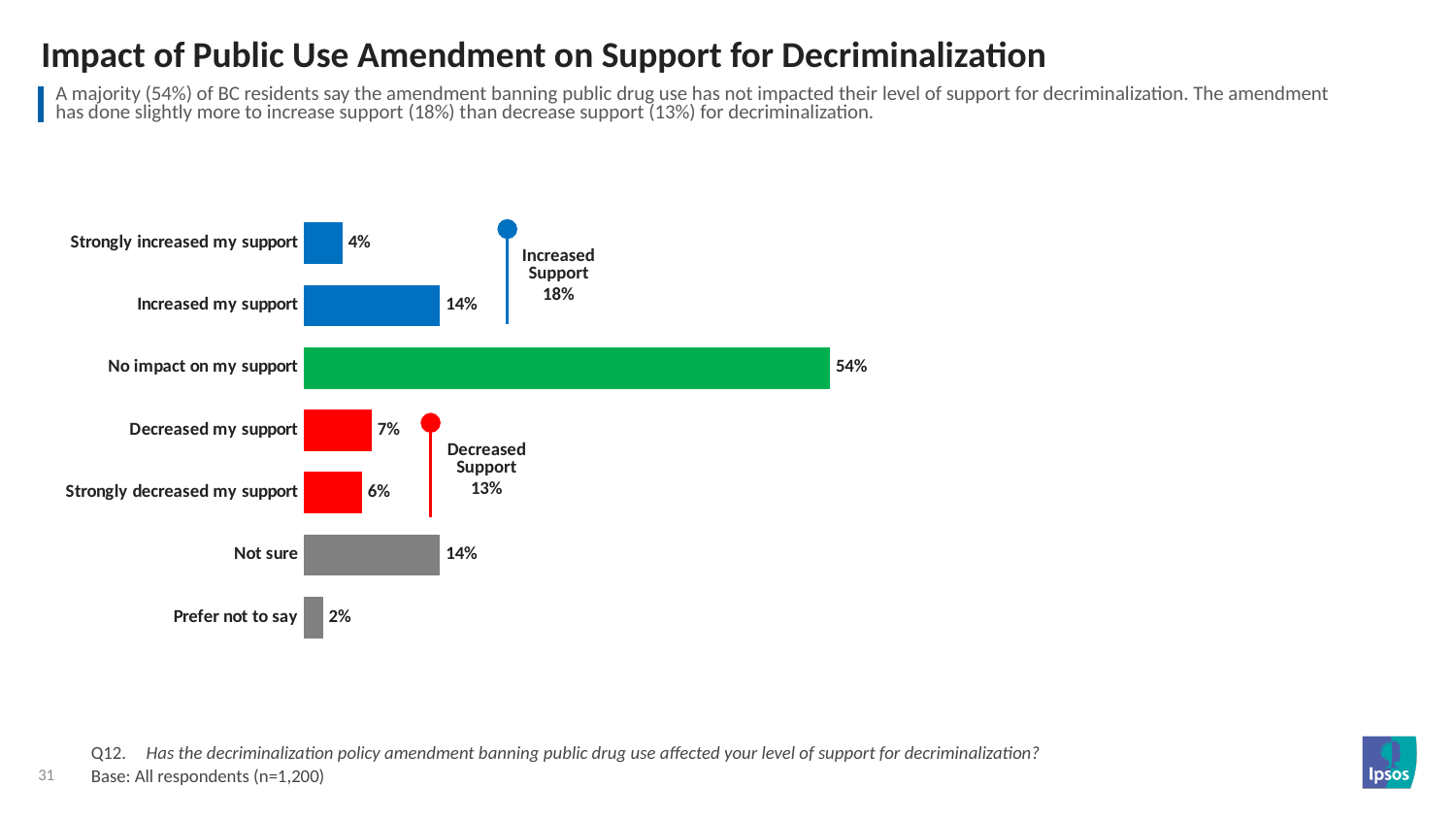
What colour is the bar for 'No impact on my support'? Green What is the value for 'Strongly increased my support'? 4% Which category has the highest value? No impact on my support What kind of chart is shown on the slide? Bar chart Which is larger: 'Decreased my support' or 'Strongly decreased my support'? Decreased my support What is the combined 'Increased Support' total shown on the chart? 18% What is the difference between 'Increased my support' and 'Decreased my support'? 7% Which category has the lowest value? Prefer not to say What is the value for 'Prefer not to say'? 2% What is the combined 'Decreased Support' total shown on the chart? 13% What percentage of respondents said the amendment had no impact on their support? 54% How many categories are shown in the chart? 7